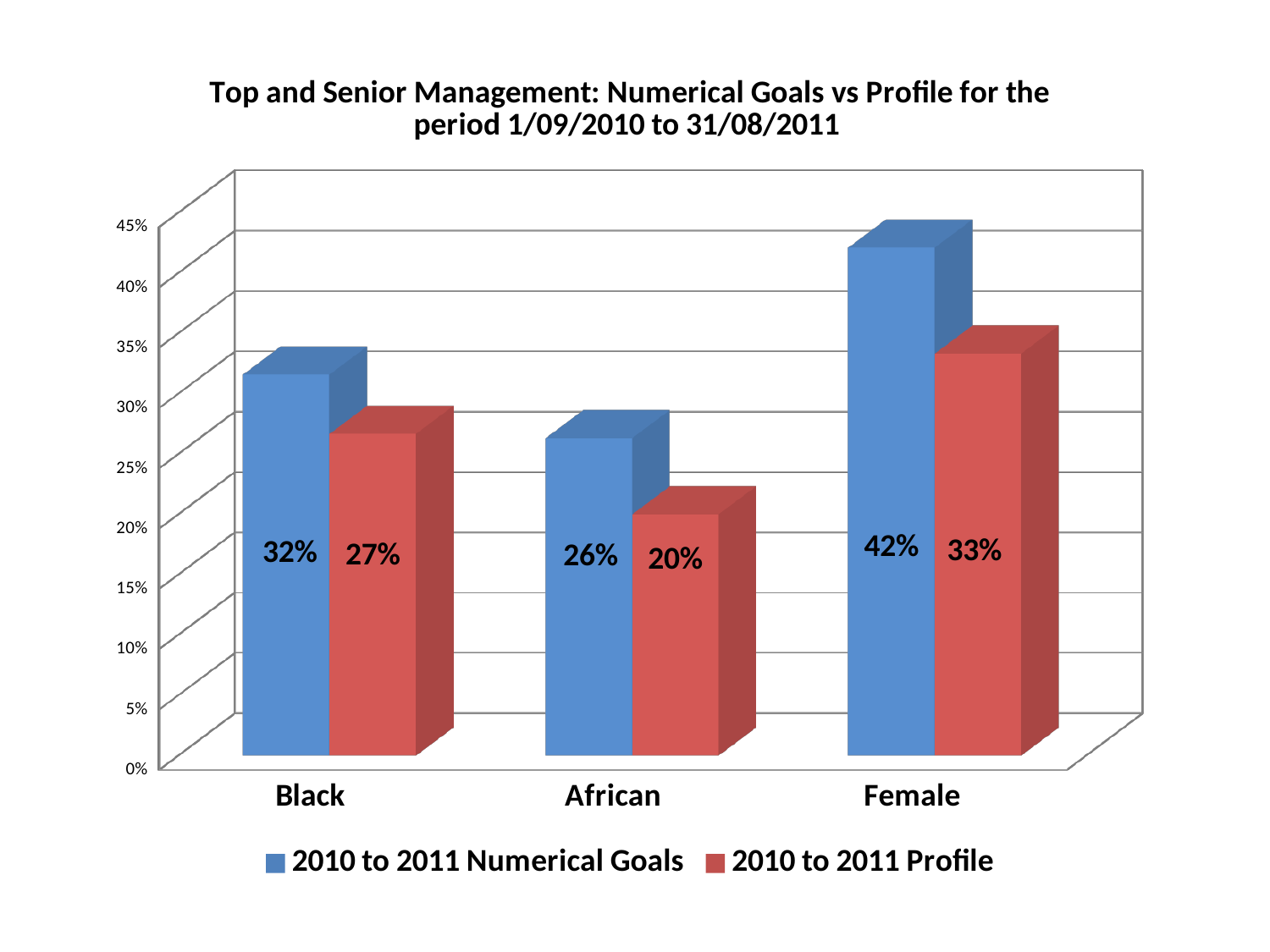
What is the 2010 to 2011 Profile value for African? 20% What is the 2010 to 2011 Profile value for Female? 33% What is the difference between the Numerical Goals value for Black and the Numerical Goals value for African? 6% What is the 2010 to 2011 Numerical Goals value for Black? 32% Which is larger for Black: the 2010 to 2011 Numerical Goals value or the 2010 to 2011 Profile value? 2010 to 2011 Numerical Goals What is the 2010 to 2011 Numerical Goals value for Female? 42% What is the difference between the Numerical Goals and Profile values for Female? 9% What kind of chart is shown on the slide? Bar chart Which category has the lowest 2010 to 2011 Profile value? African How many series does the legend list? 2 How many categories are shown on the x axis? 3 Which category has the highest 2010 to 2011 Numerical Goals value? Female